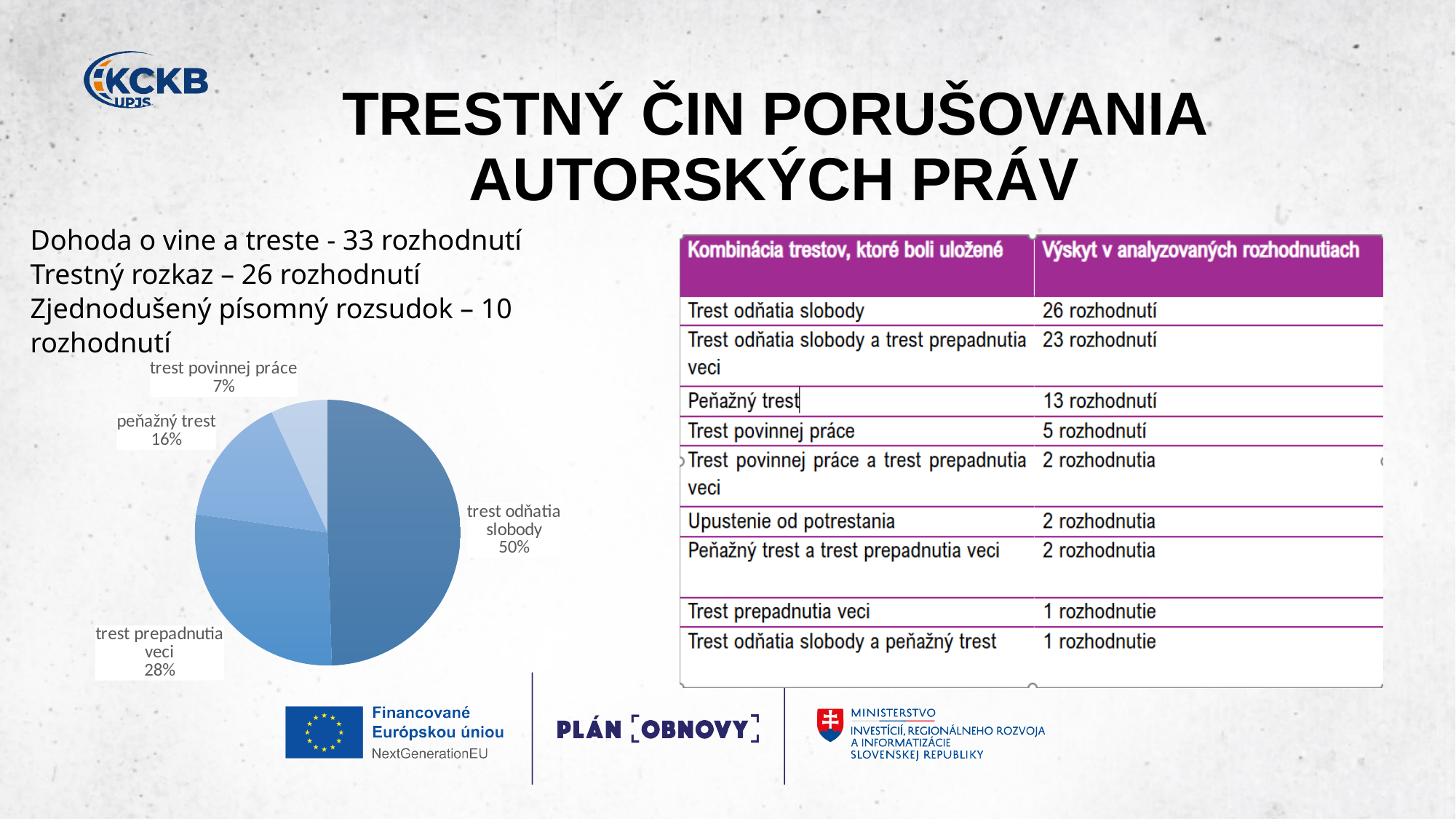
Is the share for 'trest prepadnutia veci' in the pie chart greater or less than 25%? greater What share of the pie does 'trest povinnej práce' have? 7% Which slice of the pie chart is the smallest? trest povinnej práce Which slice of the pie chart is the largest? trest odňatia slobody What share of the pie does 'trest prepadnutia veci' have? 28% How many slices does the pie chart have? 4 What share of the pie does 'peňažný trest' have? 16% What kind of chart is shown on the slide? pie chart What is the difference in percentage points between 'trest odňatia slobody' and 'trest prepadnutia veci' in the pie chart? 22 What is the difference in percentage points between 'peňažný trest' and 'trest povinnej práce' in the pie chart? 9 Which is larger in the pie chart: 'trest prepadnutia veci' or 'peňažný trest'? trest prepadnutia veci